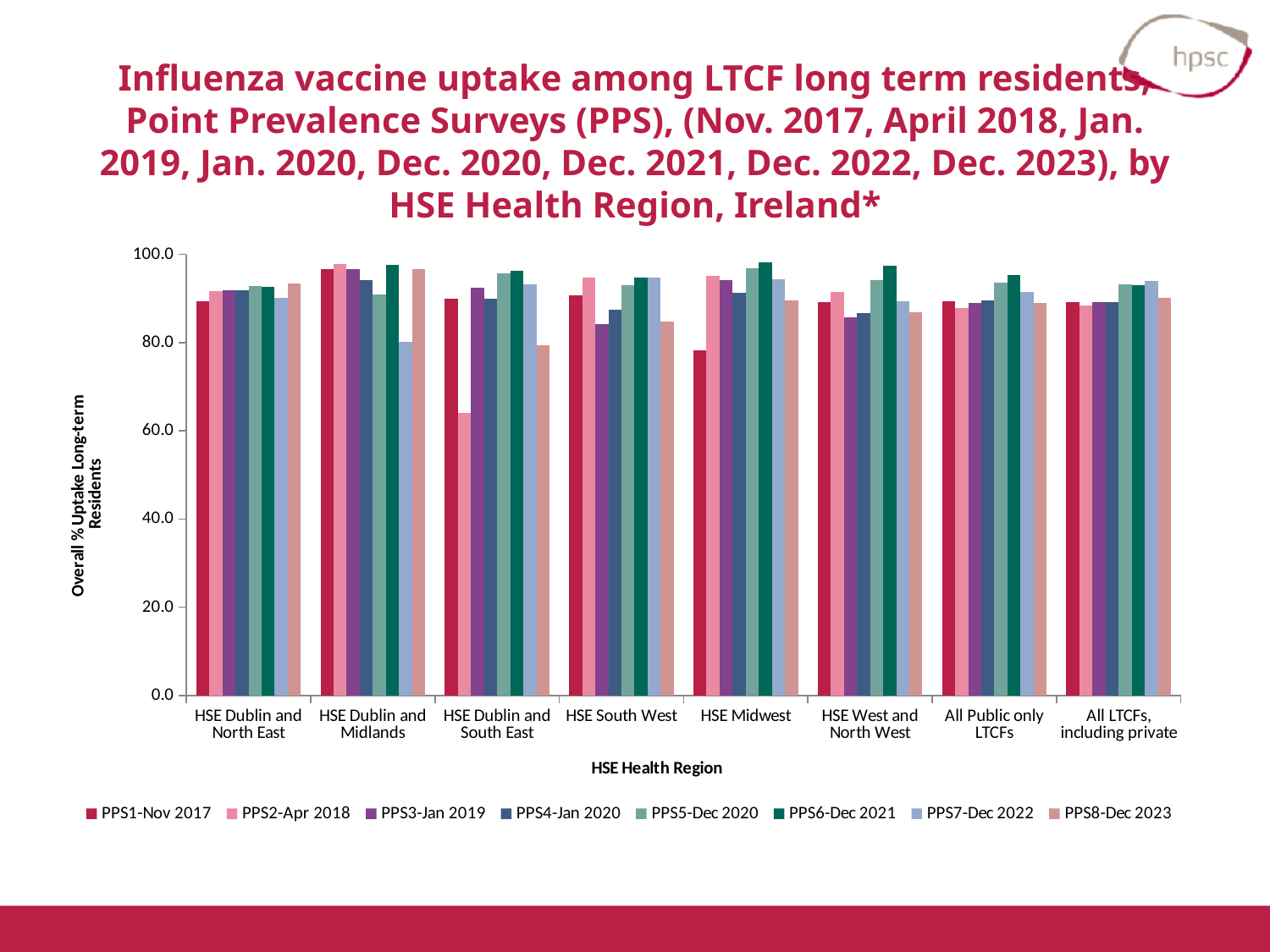
Is the value for PPS1-Nov 2017 in HSE Midwest greater or less than 80.0? less Is the value for PPS6-Dec 2021 in HSE Midwest greater or less than 90.0? greater How many series does the legend list? 8 How many HSE Health Region categories are shown on the x axis? 8 Is the value for PPS2-Apr 2018 in HSE Dublin and South East greater or less than 80.0? less For HSE Midwest, which is larger: PPS1-Nov 2017 or PPS2-Apr 2018? PPS2-Apr 2018 Which survey has the lowest uptake for HSE Midwest? PPS1-Nov 2017 What kind of chart is shown on the slide? Bar chart Which survey has the lowest uptake for HSE Dublin and South East? PPS2-Apr 2018 Which survey has the highest uptake for HSE West and North West? PPS6-Dec 2021 What is the title of the y axis? Overall % Uptake Long-term Residents